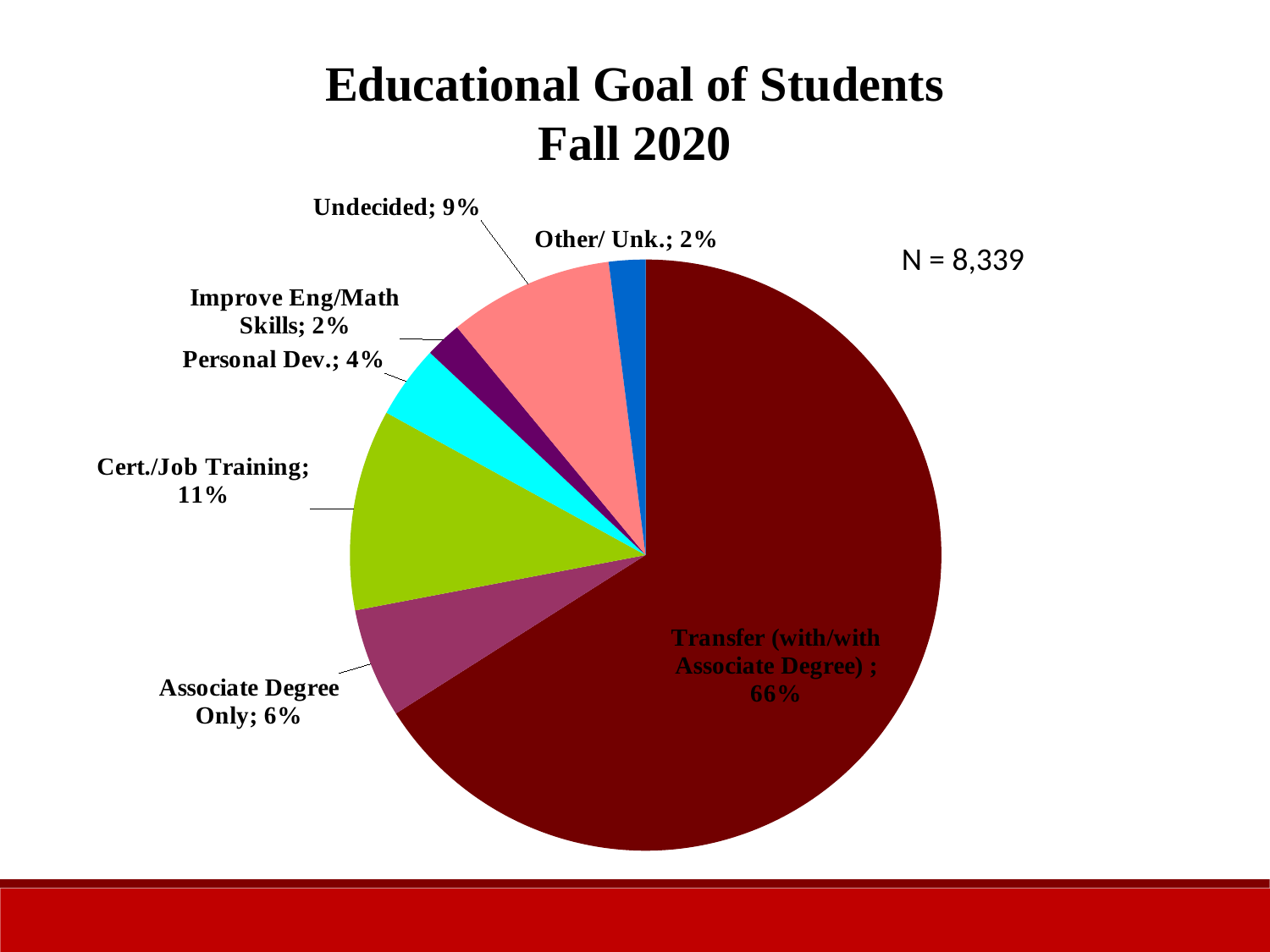
What is the total number of students (N) shown on the slide? 8,339 What share of students have the goal Associate Degree Only? 6% Which educational goal has the largest share of students? Transfer (with/with Associate Degree) What is the title of the chart? Educational Goal of Students Fall 2020 How many slices does the pie chart have? 7 What kind of chart is shown on the slide? Pie chart What share of students are Undecided? 9% What share of students have the goal Transfer (with/with Associate Degree)? 66% Which is larger, the share for Cert./Job Training or the share for Undecided? Cert./Job Training What is the difference in percentage points between the Transfer (with/with Associate Degree) share and the Cert./Job Training share? 55 percentage points